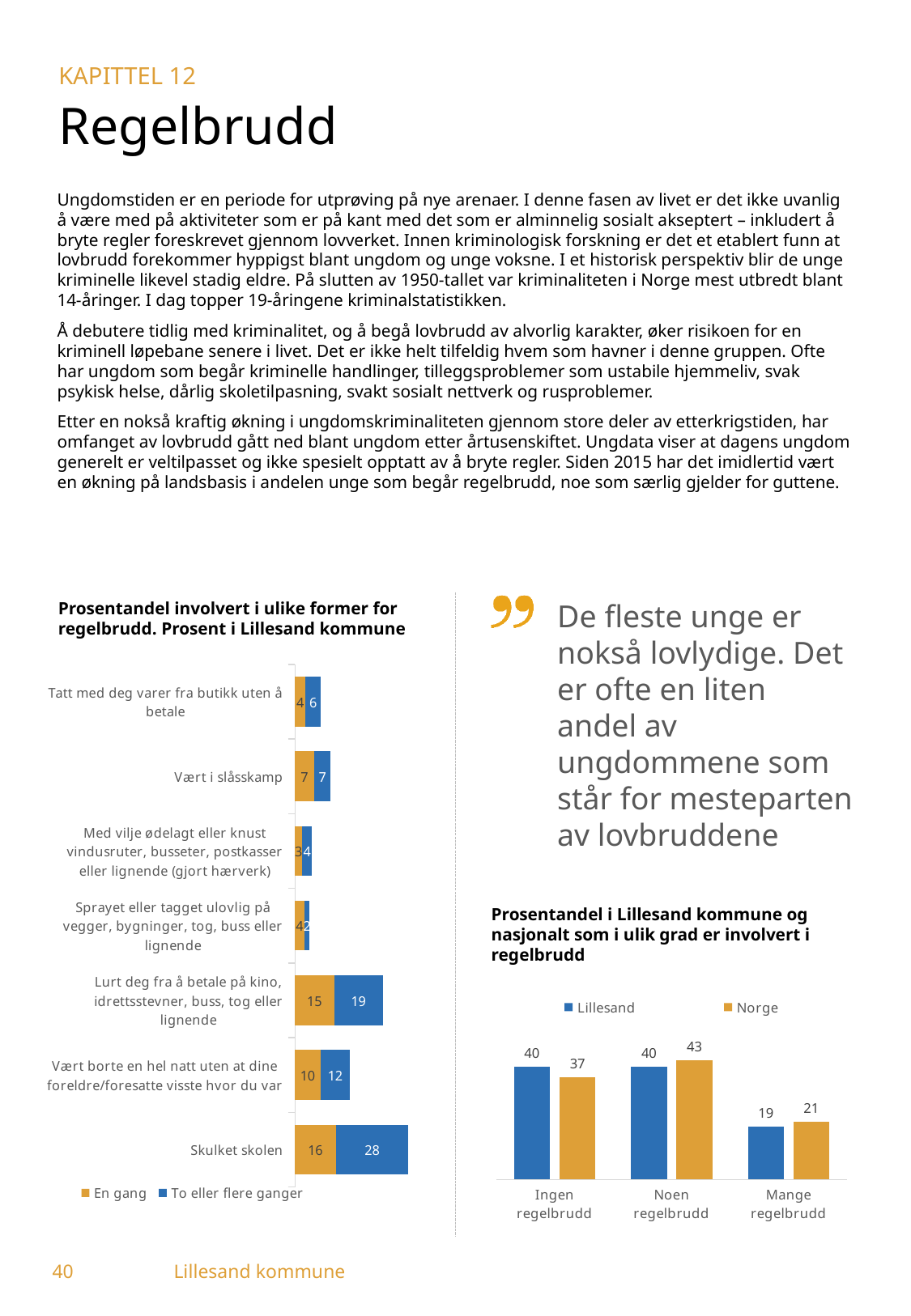
In the chart 'Prosentandel involvert i ulike former for regelbrudd', what is the total of the stacked bar for 'Vært borte en hel natt uten at dine foreldre/foresatte visste hvor du var'? 22 In the chart 'Prosentandel i Lillesand kommune og nasjonalt som i ulik grad er involvert i regelbrudd', what is the difference between Lillesand and Norge for 'Ingen regelbrudd'? 3 In the chart 'Prosentandel involvert i ulike former for regelbrudd', which category has the highest total? Skulket skolen What kind of chart is 'Prosentandel i Lillesand kommune og nasjonalt som i ulik grad er involvert i regelbrudd'? Bar chart In the chart 'Prosentandel involvert i ulike former for regelbrudd', how many series does the legend list? 2 In the chart 'Prosentandel involvert i ulike former for regelbrudd', how many categories are shown? 7 In the chart 'Prosentandel involvert i ulike former for regelbrudd', what is the value of 'En gang' for 'Lurt deg fra å betale på kino, idrettsstevner, buss, tog eller lignende'? 15 In the chart 'Prosentandel involvert i ulike former for regelbrudd', what is the value of 'To eller flere ganger' for 'Skulket skolen'? 28 In the chart 'Prosentandel i Lillesand kommune og nasjonalt som i ulik grad er involvert i regelbrudd', what is the value for Norge in 'Noen regelbrudd'? 43 In the chart 'Prosentandel i Lillesand kommune og nasjonalt som i ulik grad er involvert i regelbrudd', which is larger for 'Mange regelbrudd': Lillesand or Norge? Norge In the chart 'Prosentandel involvert i ulike former for regelbrudd', what is the total of the stacked bar for 'Skulket skolen'? 44 In the chart 'Prosentandel i Lillesand kommune og nasjonalt som i ulik grad er involvert i regelbrudd', which category has the lowest value for Lillesand? Mange regelbrudd